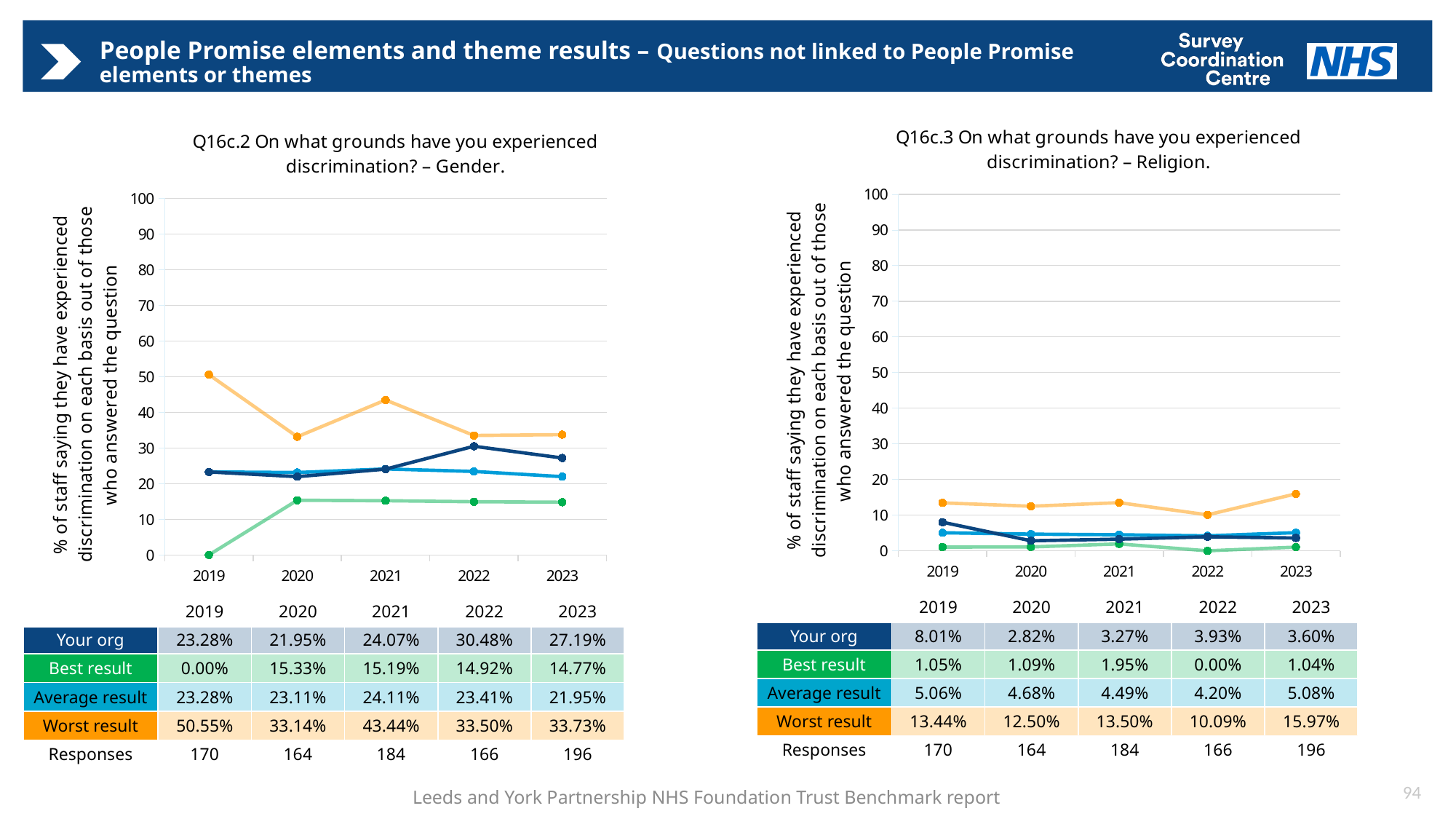
In the Q16c.3 Religion chart, what was the 'Average result' value in 2021? 4.49% In the Q16c.2 Gender chart, which year had the lowest 'Best result' value? 2019 In the Q16c.2 Gender chart, which year had the highest 'Your org' value? 2022 In the Q16c.2 Gender chart, is the 'Worst result' value for 2021 greater or less than 40? greater What type of chart is the Q16c.2 Gender chart? Line chart In the Q16c.2 Gender chart, what is the difference between the 'Worst result' and 'Your org' values in 2023? 6.54% How many years are plotted on the x axis of the Q16c.3 Religion chart? 5 In the Q16c.2 Gender chart, what was the 'Your org' value in 2022? 30.48% In the Q16c.3 Religion chart, which year had the highest 'Worst result' value? 2023 In the Q16c.3 Religion chart, which is larger in 2019: 'Your org' or 'Average result'? Your org In the Q16c.2 Gender chart, what was the 'Worst result' value in 2019? 50.55% In the Q16c.3 Religion chart, what is the difference between the 'Your org' values for 2019 and 2020? 5.19%